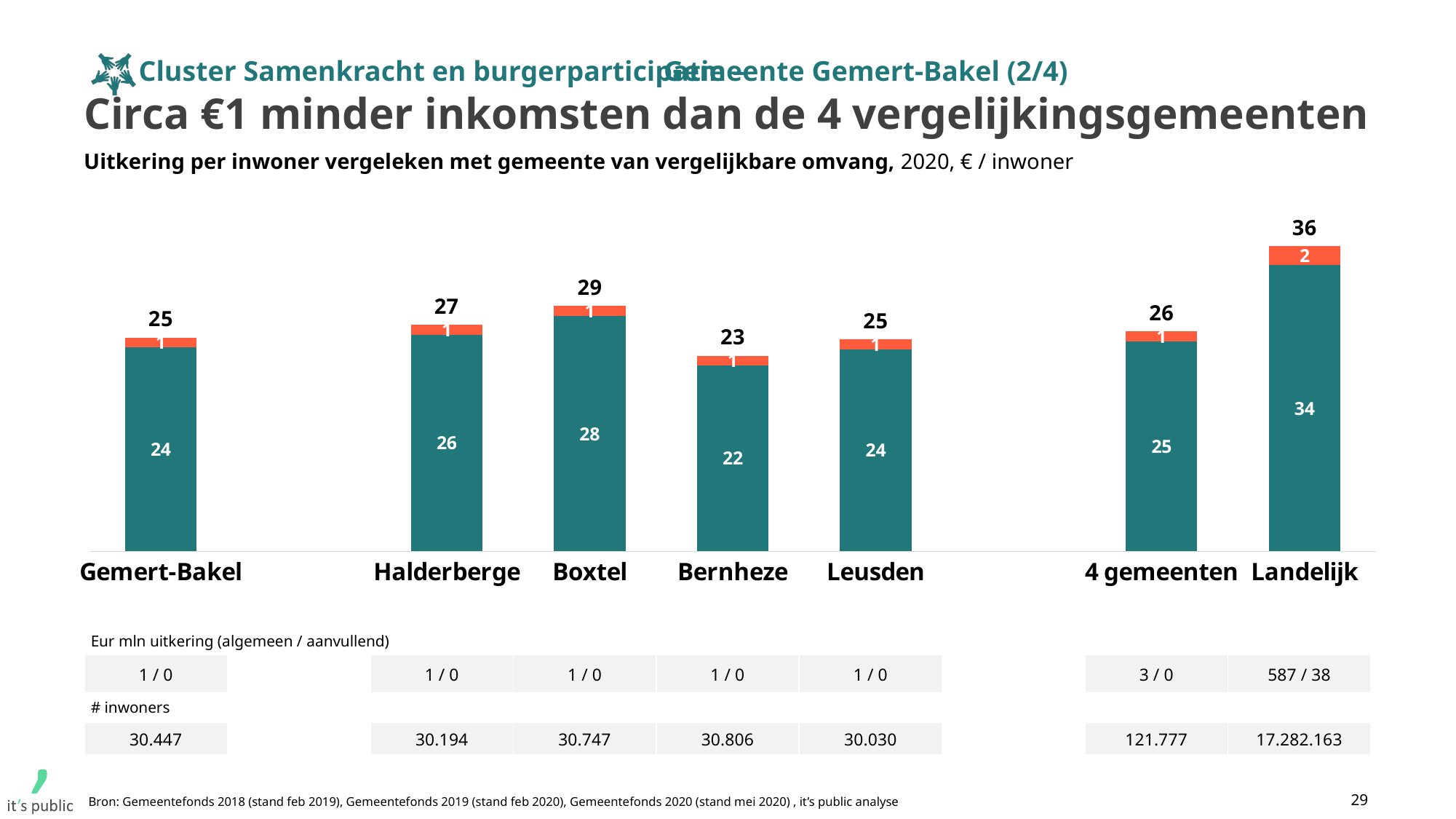
Which category has the highest total value? Landelijk What is the difference between the total for 4 gemeenten and the total for Gemert-Bakel? 1 Which category has the lowest total value? Bernheze What is the total of the stacked bar for Bernheze (teal 22 plus orange 1)? 23 What is the difference between the total for Landelijk and the total for Boxtel? 7 What is the total value shown above the bar for Gemert-Bakel? 25 What is the total value shown above the bar for Landelijk? 36 What is the value of the orange (upper) segment of the bar for Landelijk? 2 What is the value of the teal (lower) segment of the bar for Boxtel? 28 What kind of chart is shown on the slide? Stacked bar chart Which has a larger total value, Halderberge or Leusden? Halderberge How many categories (bars) are shown in the chart? 7